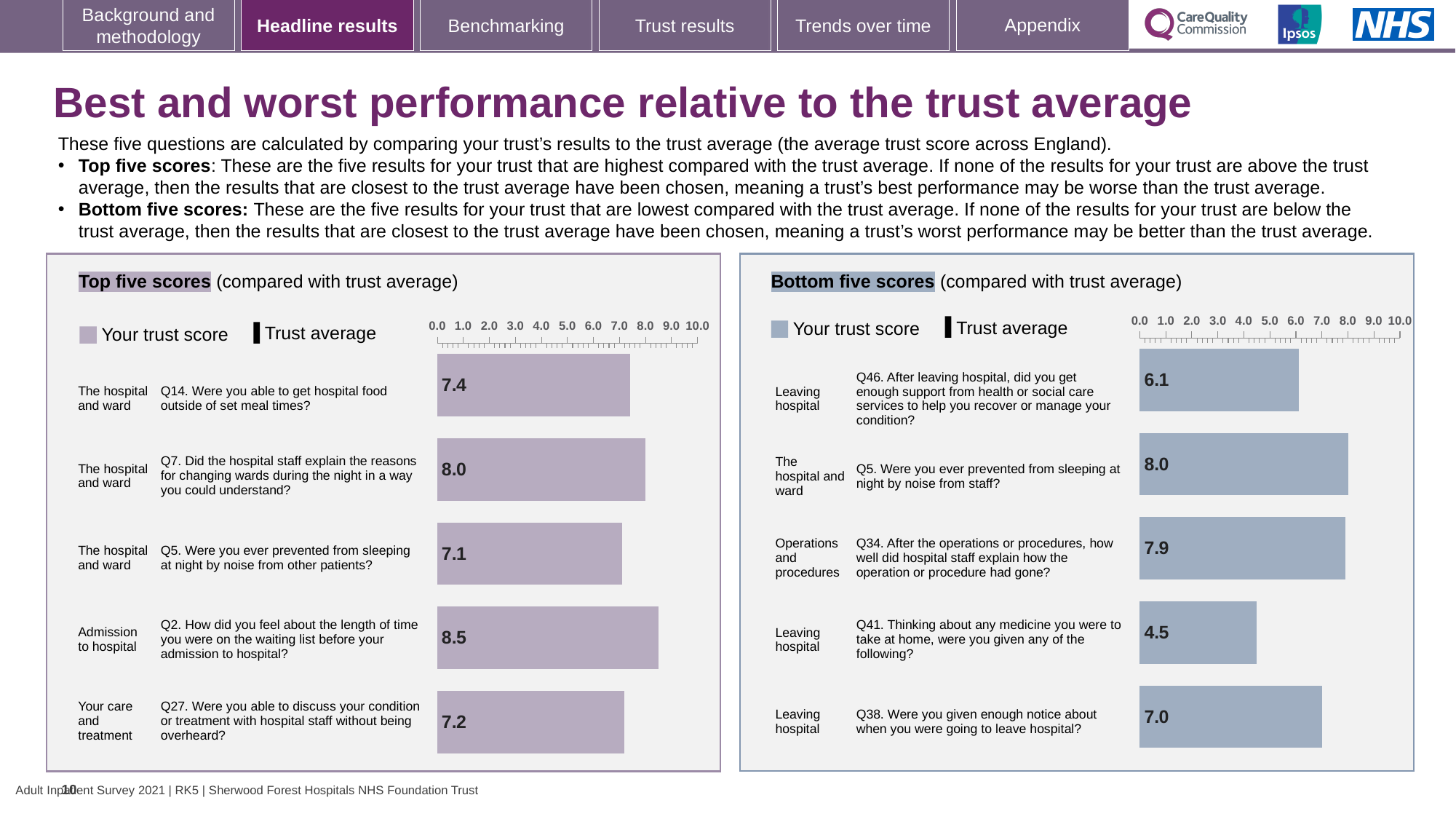
In the Bottom five scores chart, what is the trust score for Q41 (medicine to take at home)? 4.5 In the Bottom five scores chart, which question has the lowest trust score? Q41. Thinking about any medicine you were to take at home, were you given any of the following? In the Top five scores chart, which question has the highest trust score? Q2. How did you feel about the length of time you were on the waiting list before your admission to hospital? In the Bottom five scores chart, is the score for Q38 larger or smaller than the score for Q34? smaller In the Top five scores chart, what is the trust score for Q14 (getting hospital food outside of set meal times)? 7.4 In the Bottom five scores chart, what is the difference between the scores for Q5 and Q46? 1.9 In the Top five scores chart, which question has the lowest trust score? Q5. Were you ever prevented from sleeping at night by noise from other patients? In the Bottom five scores chart, what two entries does the legend list? Your trust score and Trust average In the Top five scores chart, what is the difference between the scores for Q2 and Q27? 1.3 In the Bottom five scores chart, which question has the highest trust score? Q5. Were you ever prevented from sleeping at night by noise from staff? In the Top five scores chart, how many questions are plotted? 5 What type of chart is used in the Top five scores panel? Bar chart